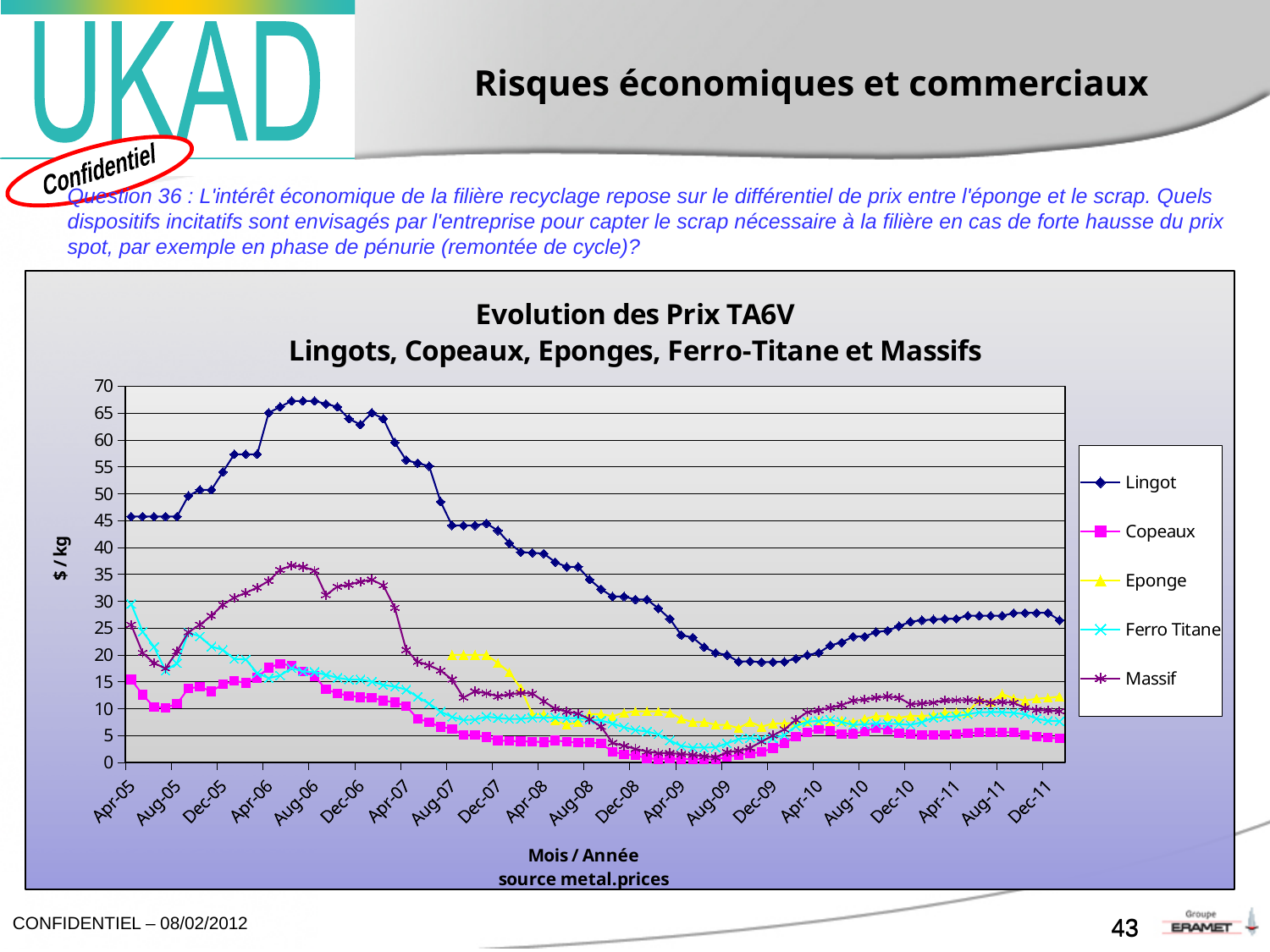
Is the value for Copeaux at Apr-09 greater or less than 5? less Is the value for Lingot at Apr-05 greater or less than 40? greater Which series has the highest values across the whole chart? Lingot Does the Lingot series rise or fall between Aug-06 and Dec-09? fall What is the label of the y axis of the chart? $ / kg What kind of chart is shown on the slide? line chart At Dec-11, which series has the larger value, Eponge or Copeaux? Eponge Is the value for Massif at Aug-06 greater or less than 30? greater At Apr-06, which series has the larger value, Lingot or Massif? Lingot How many series does the legend of the chart list? 5